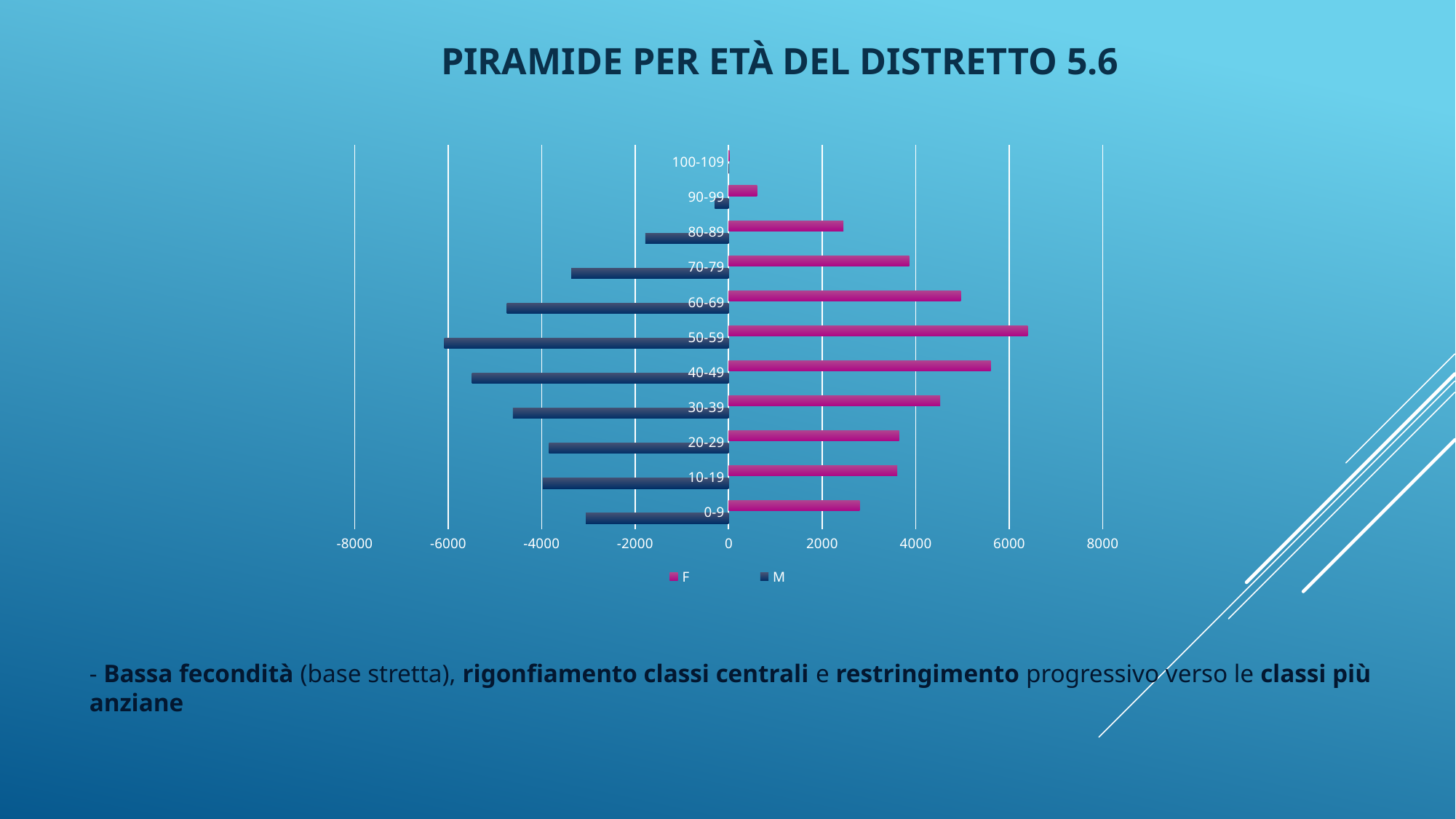
Which age group has the highest value for the F series? 50-59 Is the F value for the 50-59 age group greater or less than 6000? greater Is the F value for the 0-9 age group greater or less than 2000? greater For the F series, which is larger: the value for 50-59 or the value for 40-49? 50-59 What are the two series named in the legend? F and M Which age group has the smallest value for the F series? 100-109 Is the F value for the 20-29 age group greater or less than 4000? less How many series does the legend list? 2 How many age groups are shown on the vertical axis? 11 What is the title of the chart? PIRAMIDE PER ETÀ DEL DISTRETTO 5.6 What kind of chart is shown on the slide? bar chart